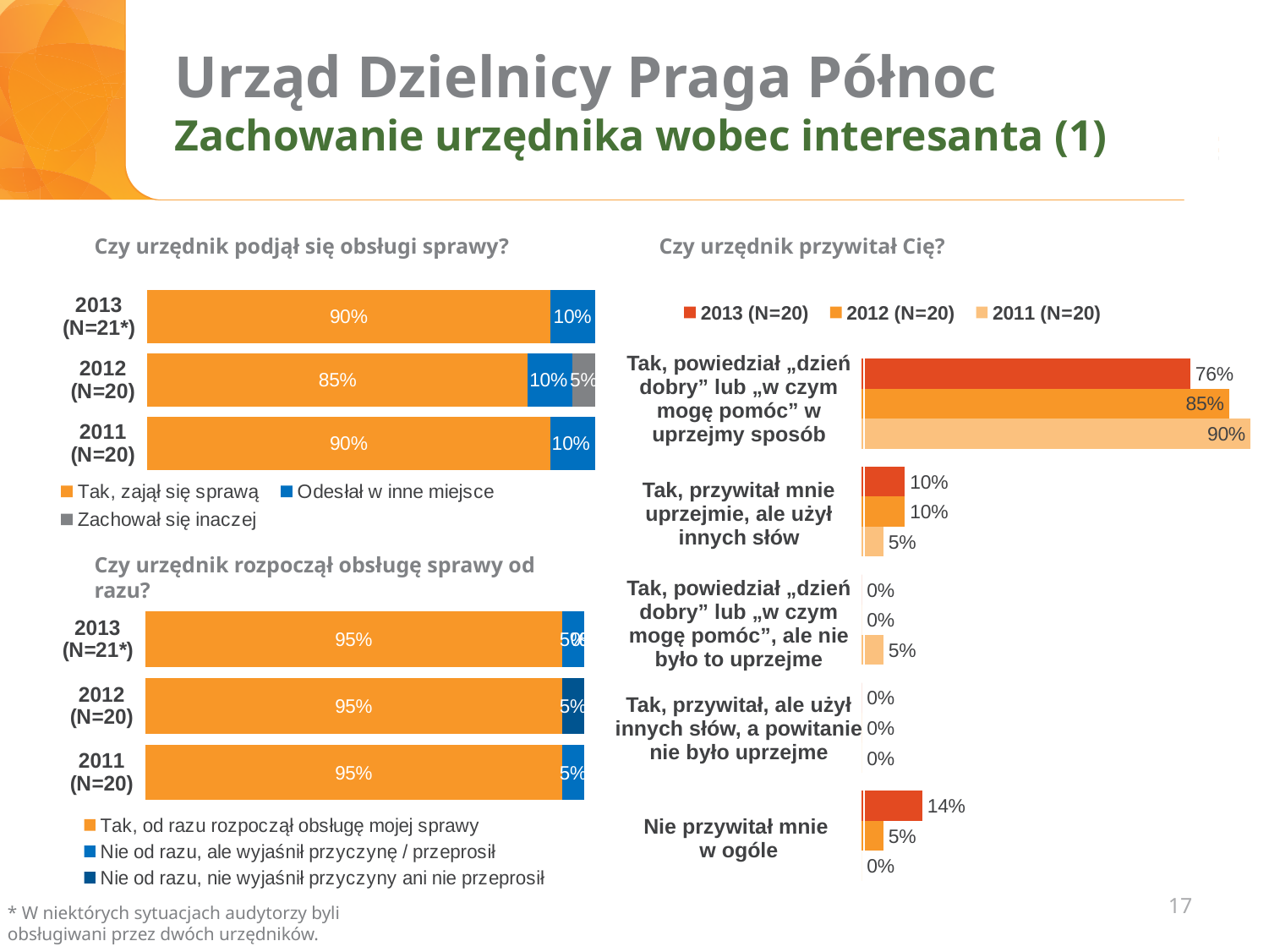
In the chart "Czy urzędnik przywitał Cię?", how many categories are shown on the vertical axis? 5 In the chart "Czy urzędnik podjął się obsługi sprawy?", what is the value for "Zachował się inaczej" in 2012 (N=20)? 5% In the chart "Czy urzędnik rozpoczął obsługę sprawy od razu?", how many year categories are shown? 3 In the chart "Czy urzędnik przywitał Cię?", what is the value for 2013 (N=20) in the category "Nie przywitał mnie w ogóle"? 14% In the chart "Czy urzędnik przywitał Cię?", which year has the highest value for "Tak, powiedział „dzień dobry” lub „w czym mogę pomóc” w uprzejmy sposób"? 2011 (N=20) In the chart "Czy urzędnik podjął się obsługi sprawy?", what is the value for "Tak, zajął się sprawą" in 2012 (N=20)? 85% In the chart "Czy urzędnik przywitał Cię?", what is the value for 2013 (N=20) in the category "Tak, powiedział „dzień dobry” lub „w czym mogę pomóc” w uprzejmy sposób"? 76% In the chart "Czy urzędnik przywitał Cię?", which is larger for "Nie przywitał mnie w ogóle": the 2013 (N=20) value or the 2012 (N=20) value? 2013 (N=20) In the chart "Czy urzędnik podjął się obsługi sprawy?", how many series does the legend list? 3 In the chart "Czy urzędnik rozpoczął obsługę sprawy od razu?", what is the value for "Tak, od razu rozpoczął obsługę mojej sprawy" in 2011 (N=20)? 95% In the chart "Czy urzędnik przywitał Cię?", what is the difference between the 2011 (N=20) and 2013 (N=20) values for "Tak, powiedział „dzień dobry” lub „w czym mogę pomóc” w uprzejmy sposób"? 14% What kind of chart is "Czy urzędnik przywitał Cię?"? Bar chart